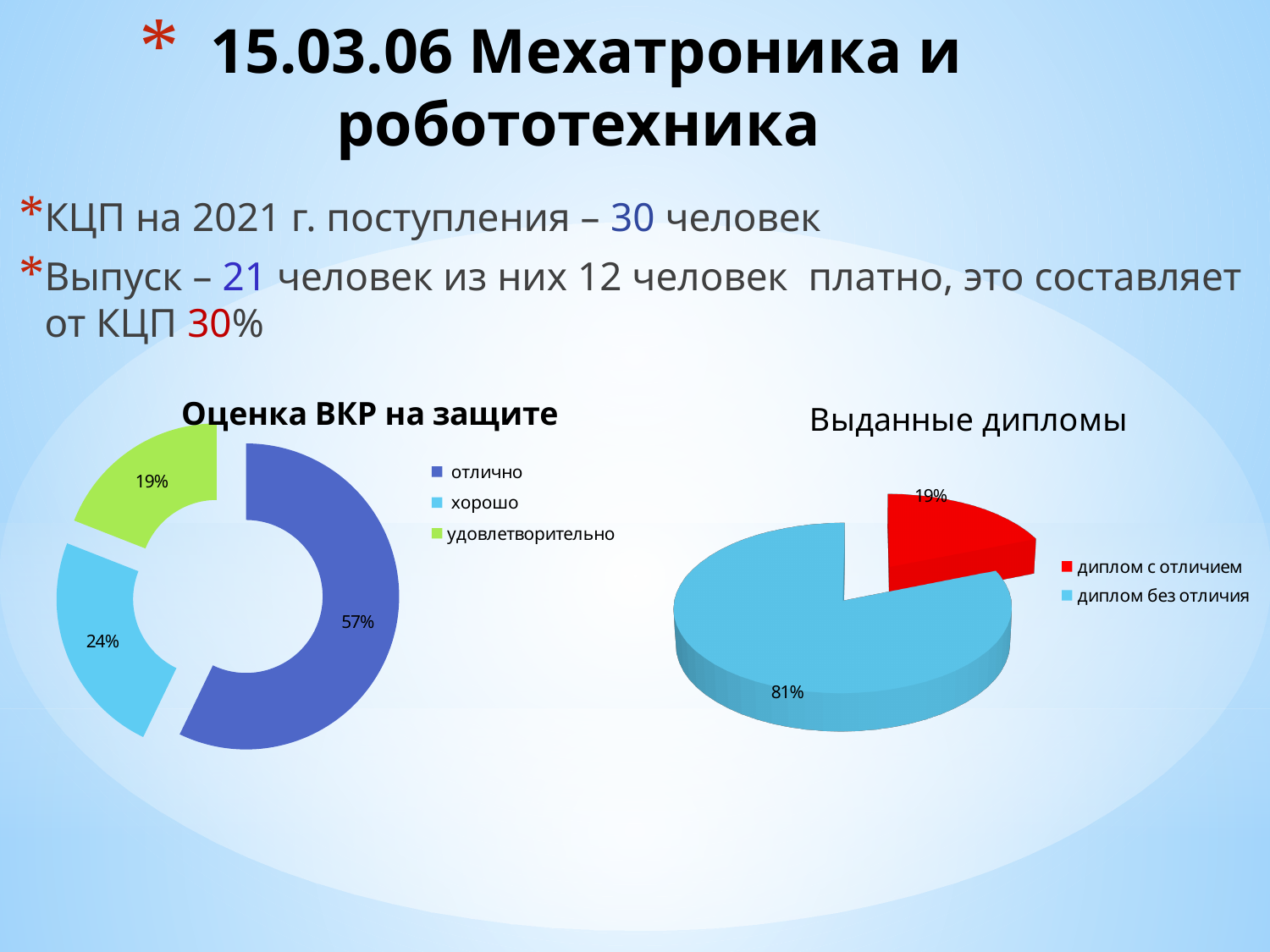
In the chart titled "Выданные дипломы", what share is labelled for "диплом с отличием"? 19% In the chart titled "Оценка ВКР на защите", which category has the largest share? отлично In the chart titled "Оценка ВКР на защите", what share is labelled for "удовлетворительно"? 19% In the chart titled "Оценка ВКР на защите", how many categories does the legend list? 3 In the chart titled "Оценка ВКР на защите", which category has the smallest share? удовлетворительно In the chart titled "Оценка ВКР на защите", what is the difference in percentage points between "отлично" and "хорошо"? 33 What kind of chart is the one titled "Выданные дипломы"? pie chart In the chart titled "Оценка ВКР на защите", what share is labelled for "хорошо"? 24% In the chart titled "Выданные дипломы", which category has the larger share: "диплом с отличием" or "диплом без отличия"? диплом без отличия In the chart titled "Выданные дипломы", what share is labelled for "диплом без отличия"? 81% In the chart titled "Выданные дипломы", what colour is the slice for "диплом с отличием"? red In the chart titled "Оценка ВКР на защите", what share is labelled for "отлично"? 57%